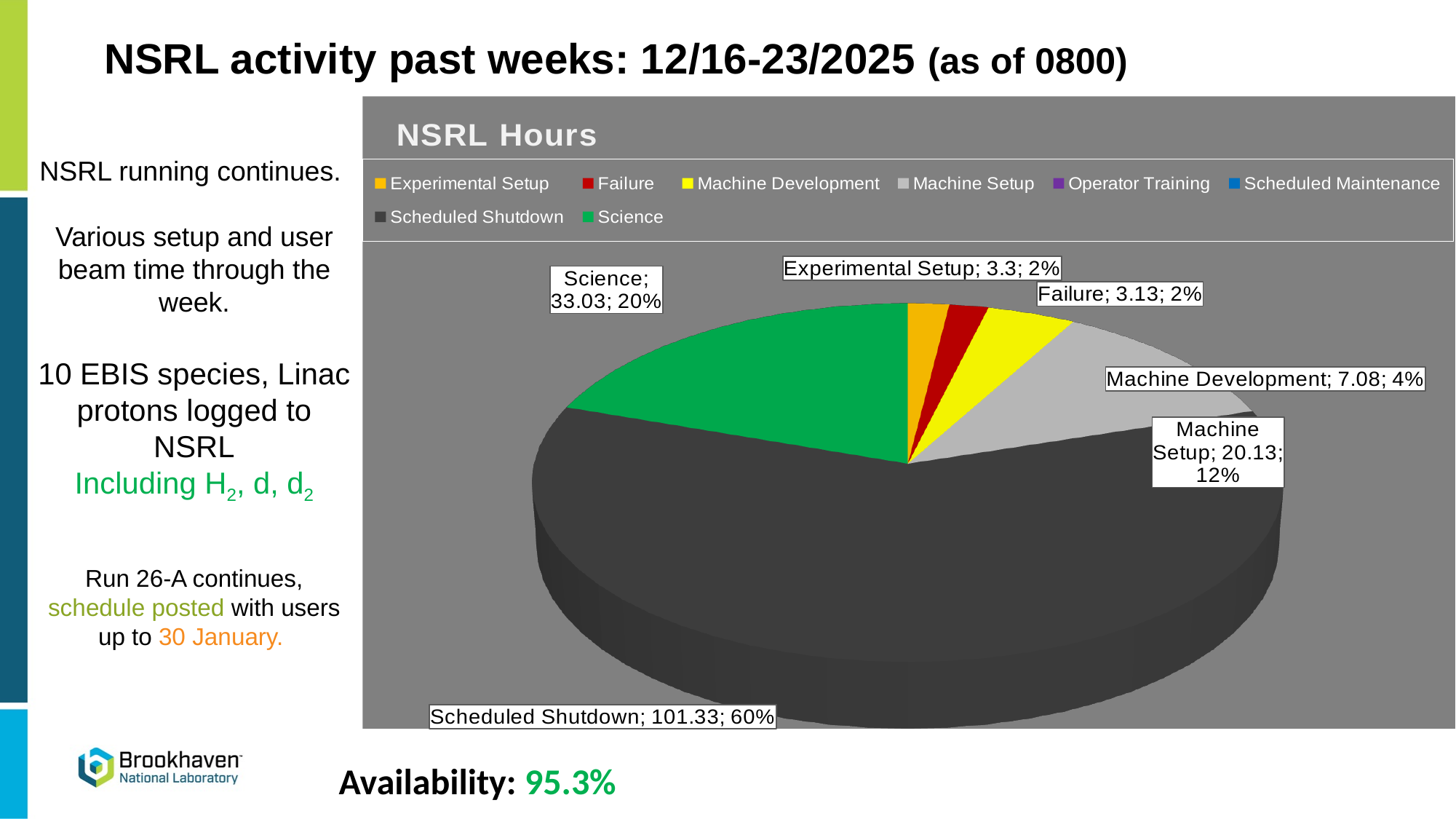
What percentage share of the pie does Science have? 20% How many hours are labelled for Machine Setup? 20.13 Which category has the largest slice of the pie? Scheduled Shutdown What is the title of the chart? NSRL Hours What is the difference in hours between Scheduled Shutdown and Science? 68.3 Which labelled category has the smallest number of hours? Failure How many slices of the pie have data labels? 6 Which has more hours, Machine Setup or Machine Development? Machine Setup How many entries does the chart legend list? 8 How many hours are labelled for Science? 33.03 What type of chart is shown on the slide? pie chart How many hours are labelled for Scheduled Shutdown? 101.33